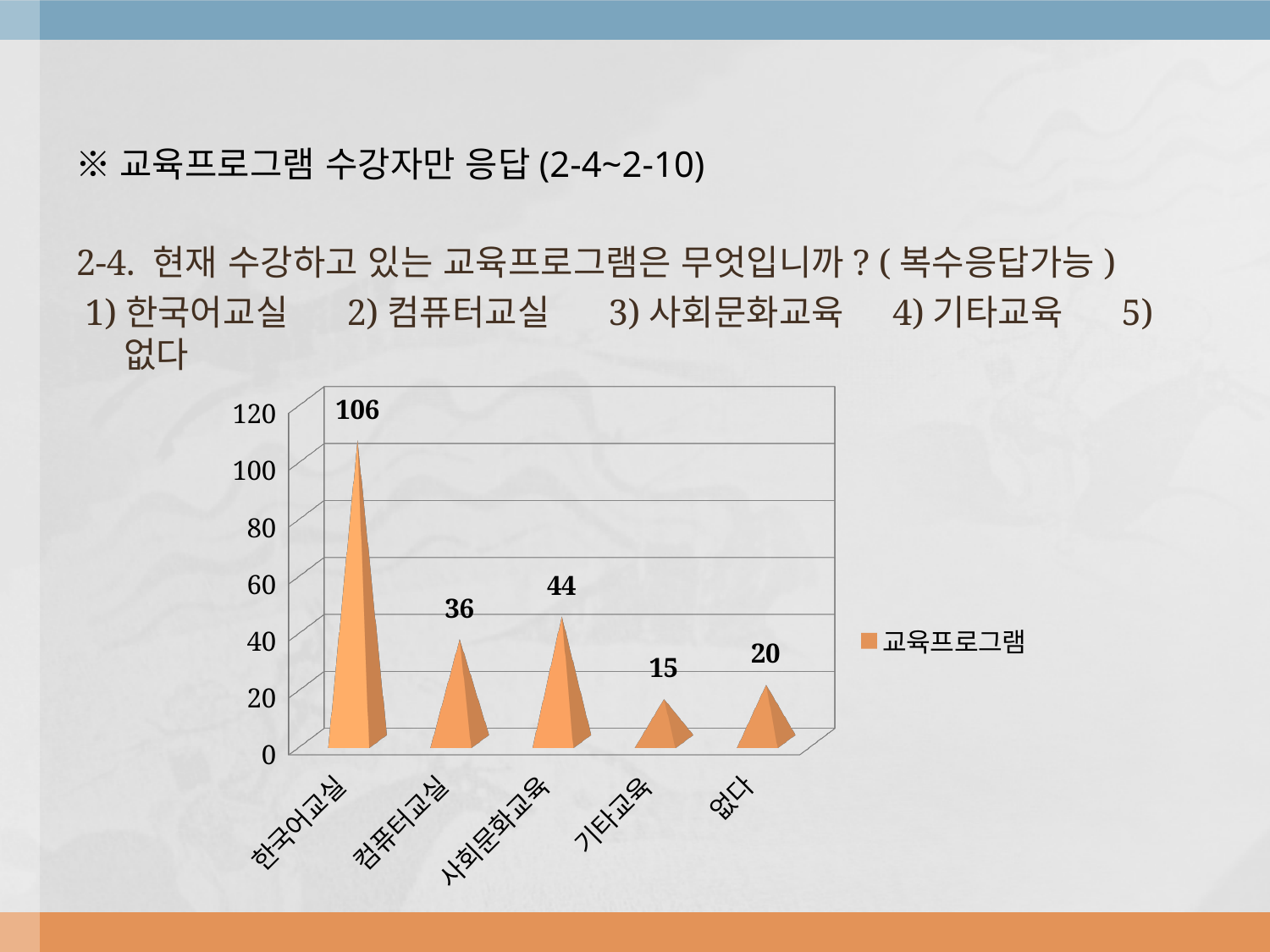
What is the value for 기타교육? 15 Which is larger, the value for 컴퓨터교실 or the value for 사회문화교육? 사회문화교육 Which category has the lowest value? 기타교육 How many series does the legend list? 1 What kind of chart is shown on the slide? bar chart What is the value for 컴퓨터교실? 36 How many categories are shown on the x axis? 5 Which category has the highest value? 한국어교실 What is the value for 사회문화교육? 44 What is the difference between the values for 한국어교실 and 사회문화교육? 62 What is the value for 없다? 20 What is the value for 한국어교실? 106